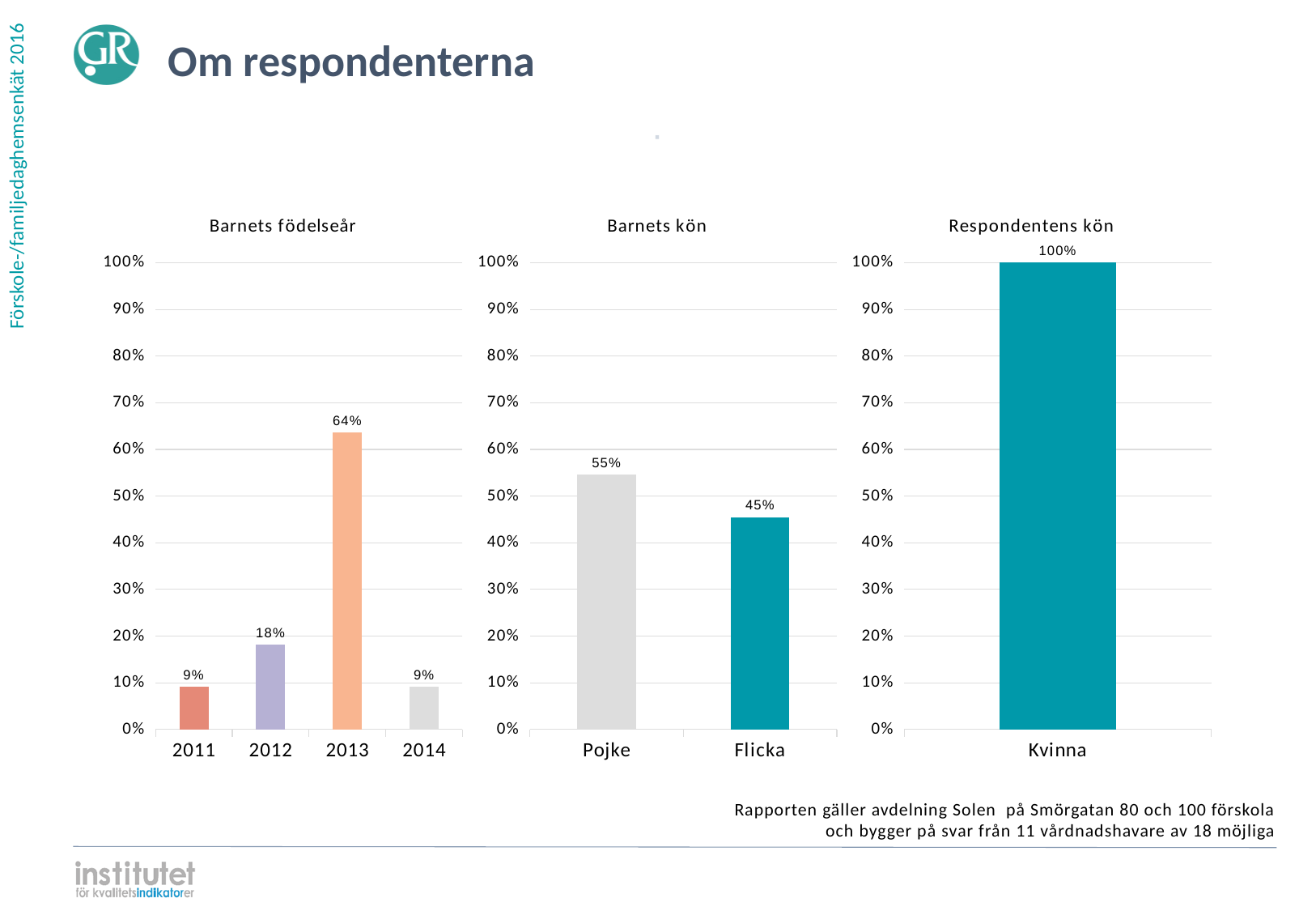
In the 'Barnets födelseår' chart, what is the value for 2013? 64% In the 'Barnets födelseår' chart, what is the difference between the values for 2013 and 2012? 46% In the 'Barnets kön' chart, which is larger, Pojke or Flicka? Pojke In the 'Barnets kön' chart, what is the value for Pojke? 55% In the 'Barnets födelseår' chart, what is the value for 2012? 18% In the 'Barnets kön' chart, what is the value for Flicka? 45% In the 'Respondentens kön' chart, how many categories are shown? 1 In the 'Barnets födelseår' chart, which year has the highest value? 2013 What kind of chart is the 'Barnets kön' chart? Bar chart In the 'Barnets födelseår' chart, how many years are shown on the x axis? 4 In the 'Respondentens kön' chart, what is the value for Kvinna? 100% In the 'Barnets kön' chart, what is the difference between Pojke and Flicka? 10%